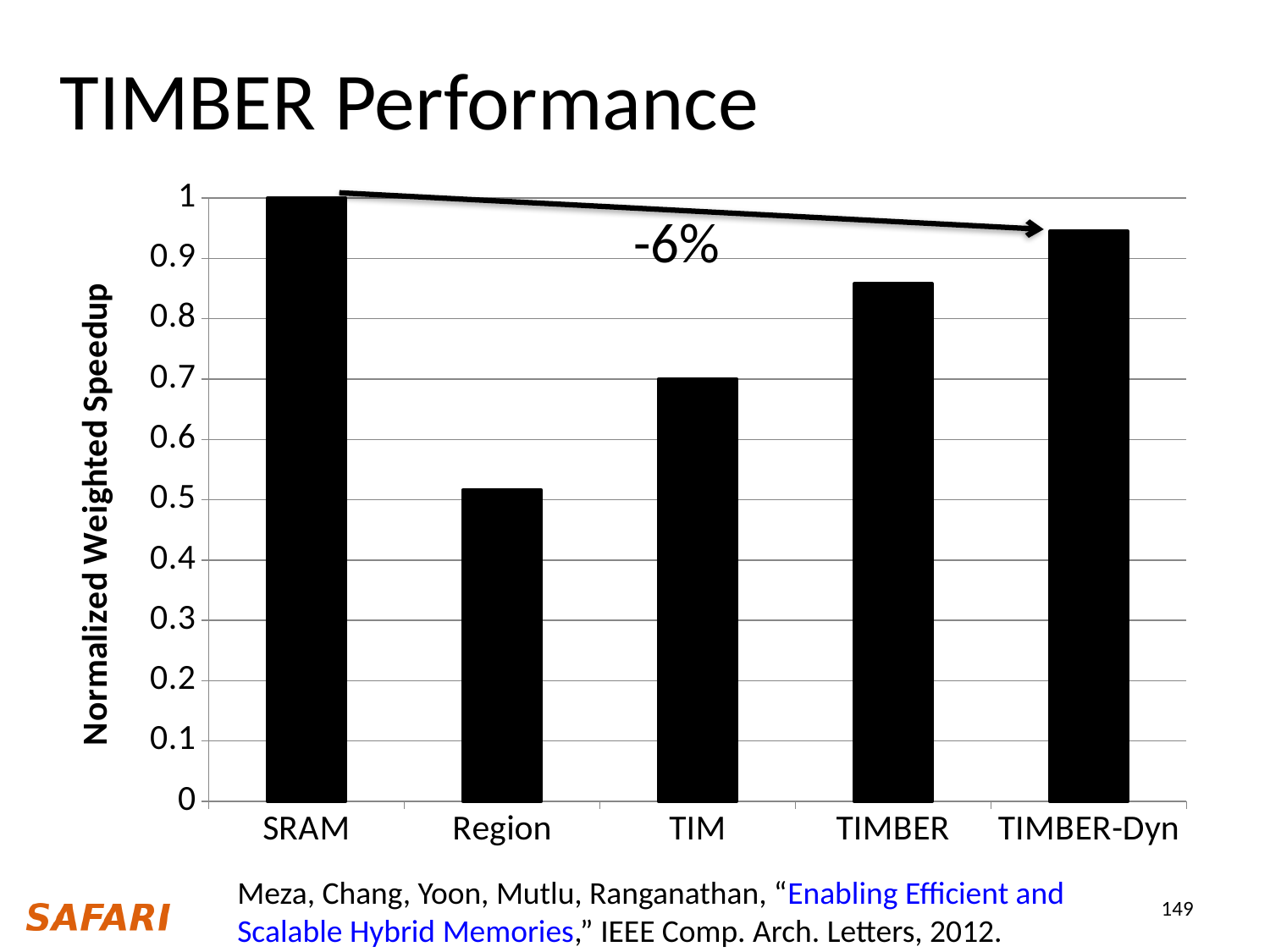
Which has a higher Normalized Weighted Speedup, TIM or TIMBER? TIMBER Is the value for TIM greater or less than 0.8? less Which category has the highest Normalized Weighted Speedup? SRAM Is the value for Region greater or less than 0.6? less What is the label of the y axis? Normalized Weighted Speedup Is the value for TIMBER-Dyn greater or less than 0.9? greater What is the Normalized Weighted Speedup for SRAM? 1 What percentage is written next to the arrow from SRAM to TIMBER-Dyn? -6% How many categories are shown on the x axis of the chart? 5 What type of chart is shown on the slide? bar chart Which category has the lowest Normalized Weighted Speedup? Region